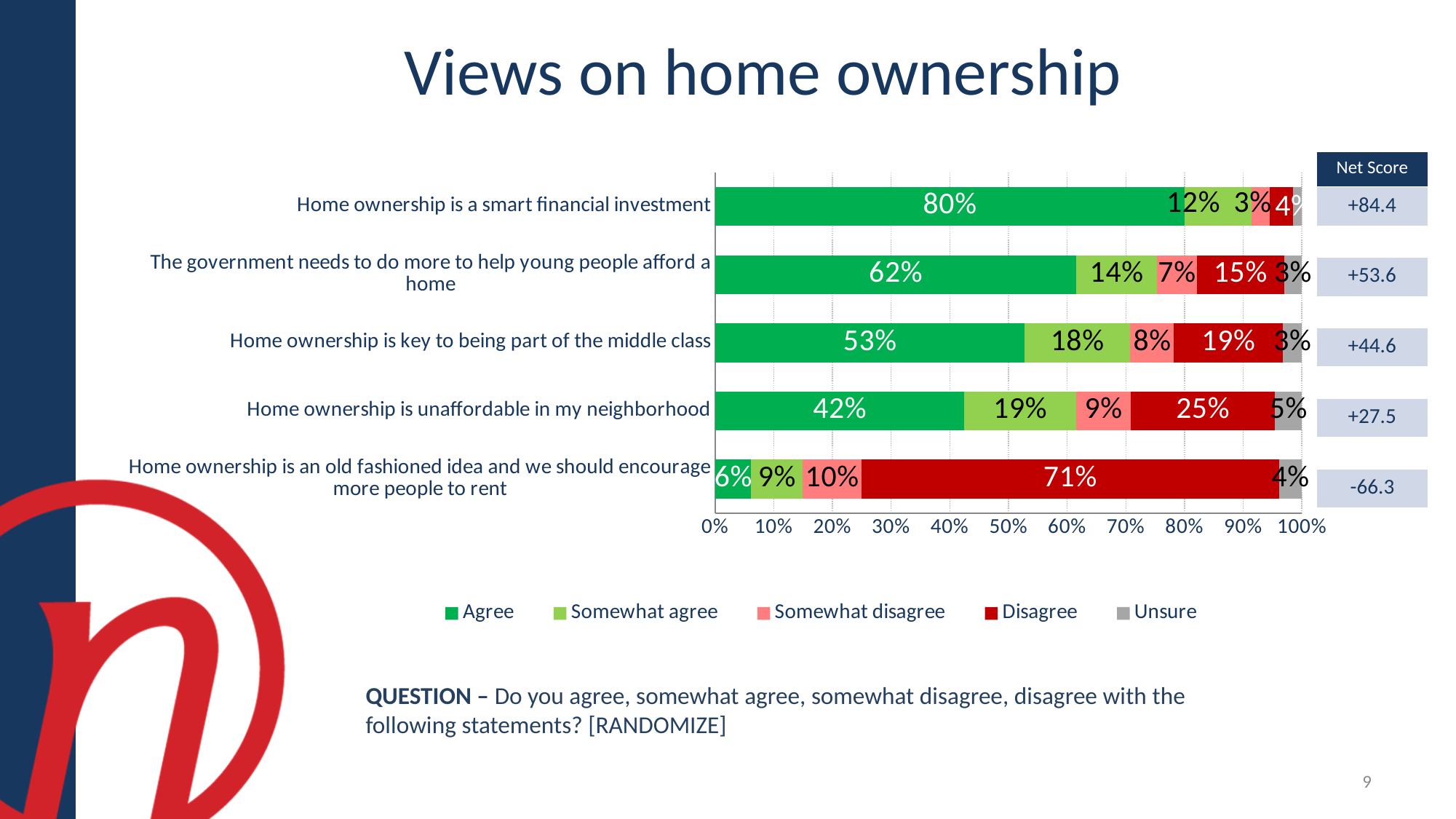
Which is larger: the Disagree value for 'Home ownership is unaffordable in my neighborhood' or the Disagree value for 'Home ownership is key to being part of the middle class'? Home ownership is unaffordable in my neighborhood What is the Net Score shown for 'Home ownership is key to being part of the middle class'? +44.6 What is the Disagree value for the statement 'Home ownership is an old fashioned idea and we should encourage more people to rent'? 71% What is the title of the slide? Views on home ownership What percentage of respondents agree that home ownership is a smart financial investment? 80% What is the Somewhat agree value for 'Home ownership is unaffordable in my neighborhood'? 19% Which statement has the highest Agree percentage? Home ownership is a smart financial investment What kind of chart is shown on the slide? Stacked bar chart What is the difference between the Agree percentages for 'The government needs to do more to help young people afford a home' and 'Home ownership is key to being part of the middle class'? 9% How many series does the legend list? 5 How many statements are shown in the chart? 5 Which statement has the lowest Net Score? Home ownership is an old fashioned idea and we should encourage more people to rent